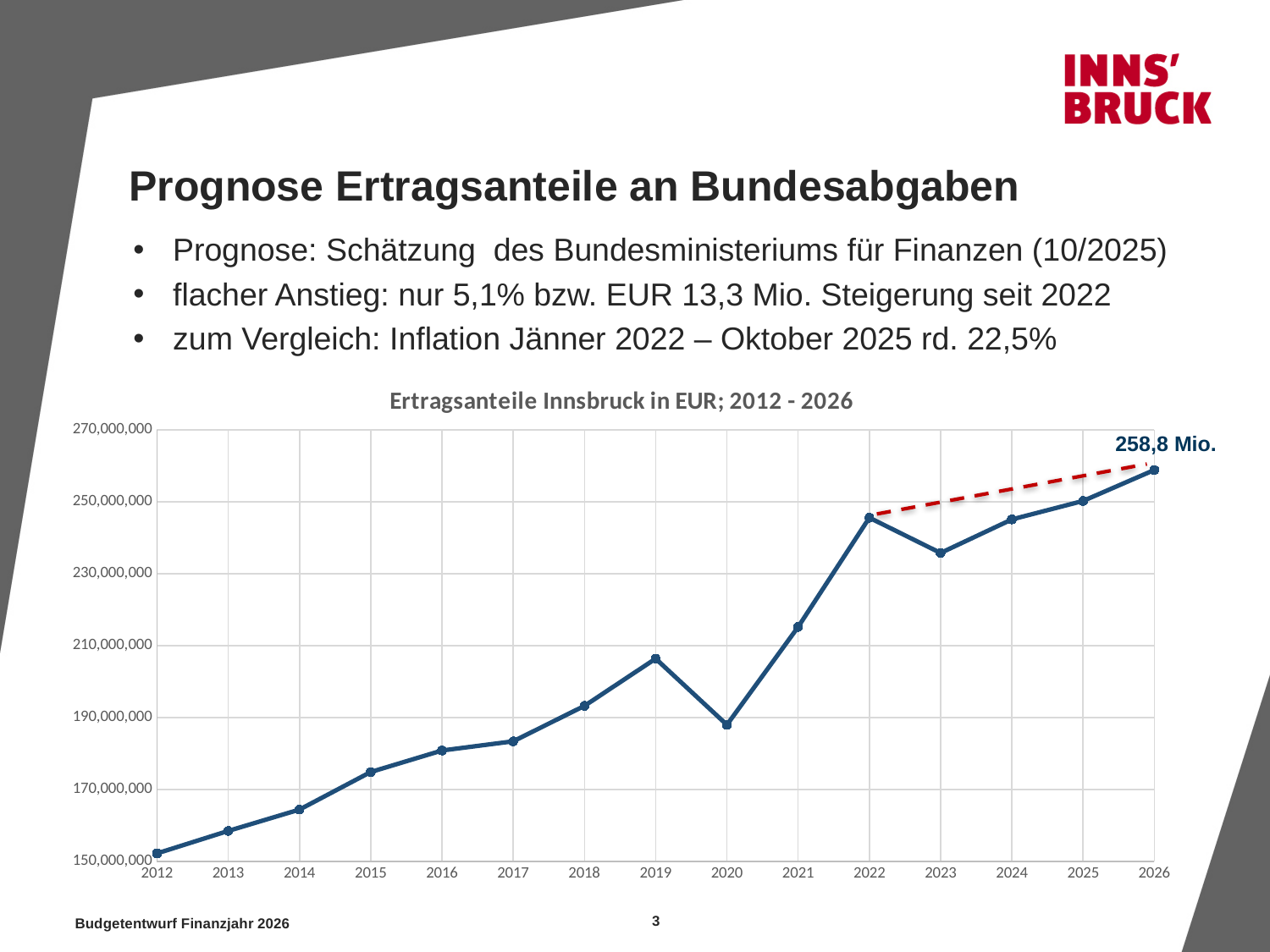
Do the values generally rise or fall from 2012 to 2026? rise How many years are plotted on the x axis of the chart? 15 What value is labelled on the chart for 2026? 258,8 Mio. Which year has the larger value, 2022 or 2023? 2022 Is the value for 2019 greater or less than 190,000,000? greater What is the title of the chart? Ertragsanteile Innsbruck in EUR; 2012 - 2026 Is the value for 2020 greater or less than 210,000,000? less Which year has the lowest value in the chart? 2012 Is the value for 2022 greater or less than 230,000,000? greater Which year has the larger value, 2019 or 2020? 2019 Which year has the highest value in the chart? 2026 What kind of chart is shown on the slide? line chart